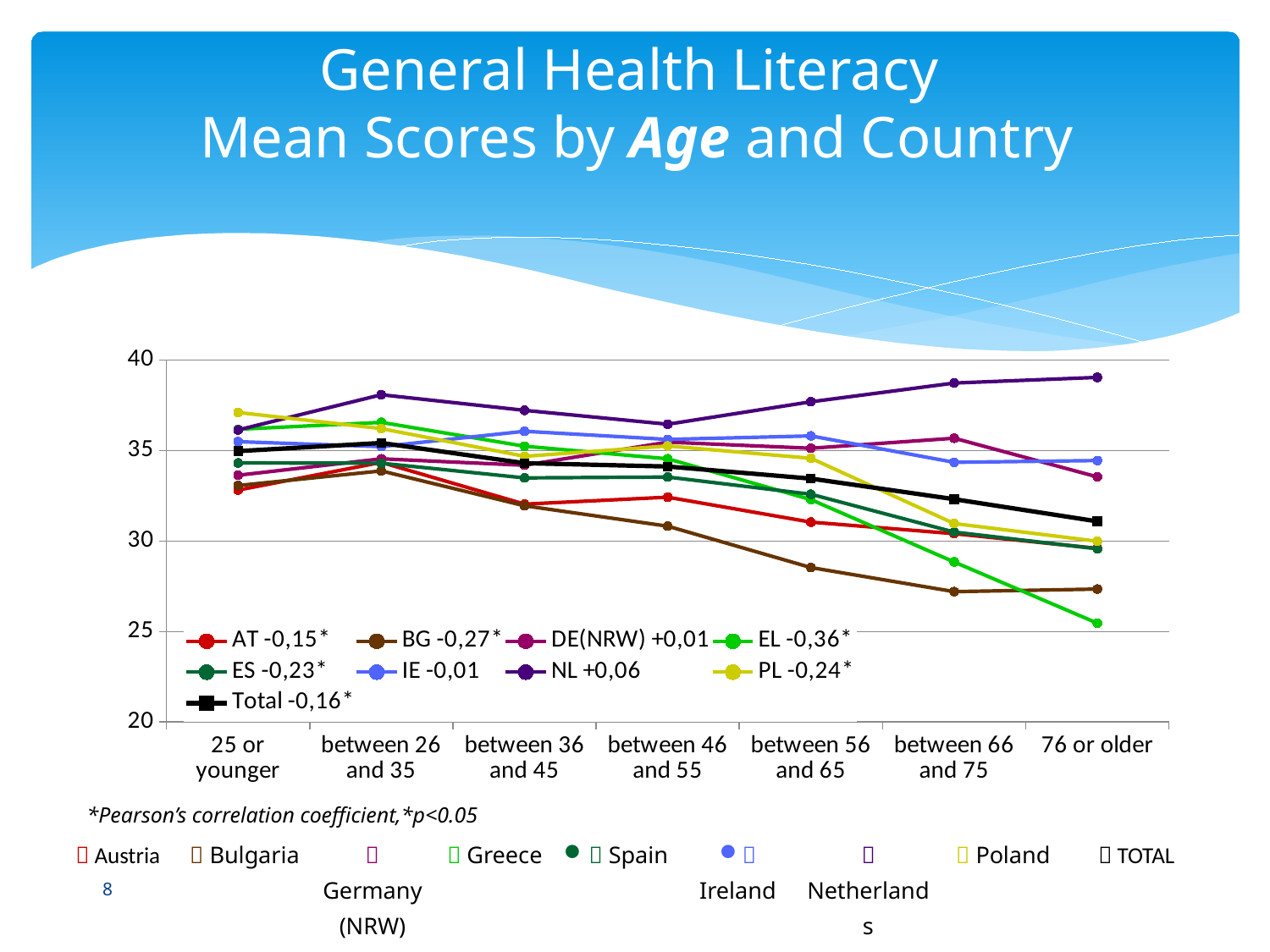
What is the legend label for the Total series? Total -0,16* Which country has the lowest mean score for the '76 or older' age group? EL Which series has the lowest value for the 'between 56 and 65' age group? BG What kind of chart is shown on the slide? line chart Is the value for BG in the 'between 66 and 75' group greater or less than 30? less Is the value for EL in the '76 or older' group greater or less than 30? less Which country has the highest mean score for the '76 or older' age group? NL How many series does the chart legend list? 9 Does the Total series rise or fall as age increases along the x axis? fall Which is larger for the '76 or older' group, the value for NL or the value for EL? NL How many age categories are shown on the x axis? 7 Is the value for NL in the '76 or older' group greater or less than 35? greater